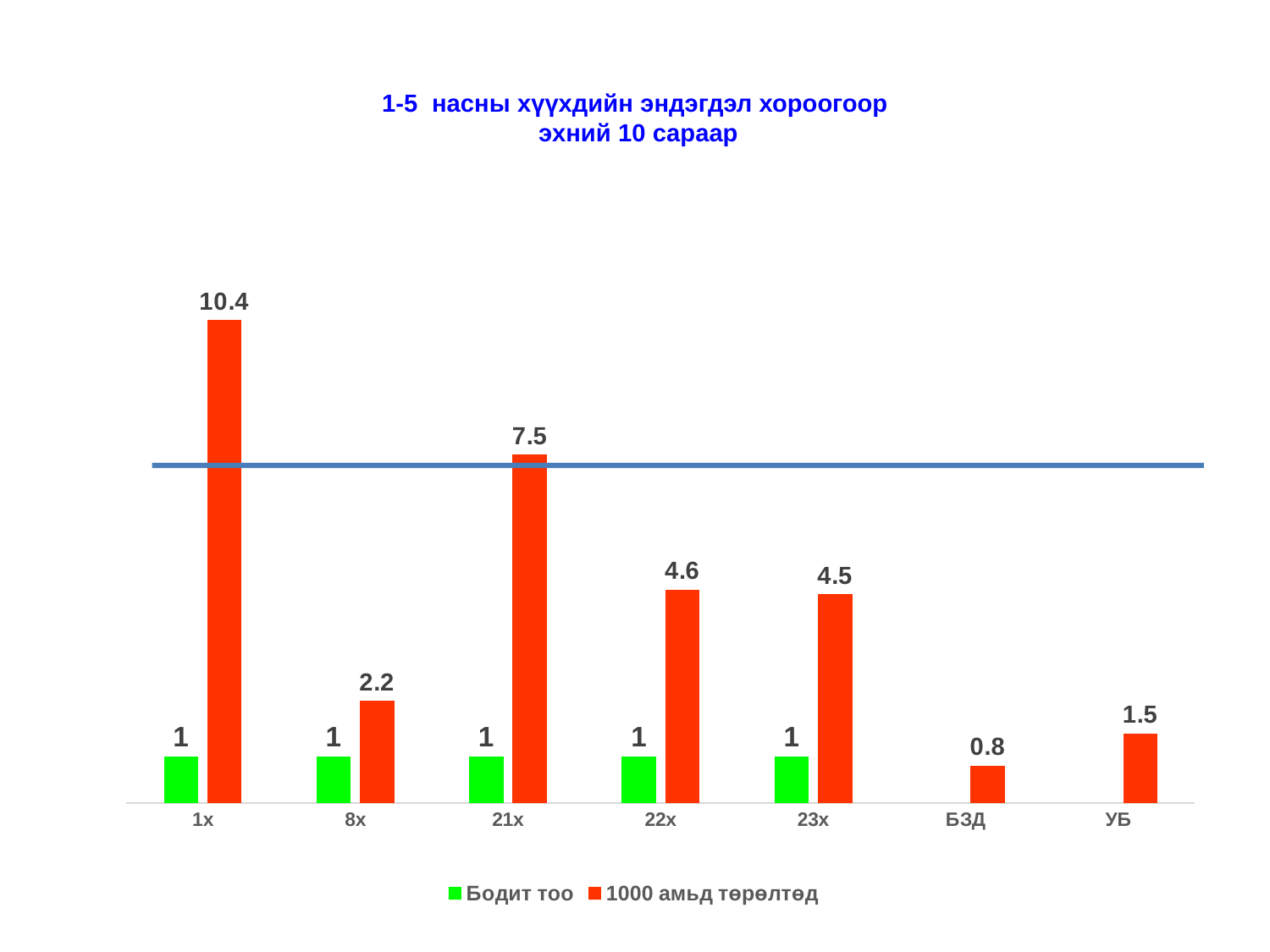
What is the value of the '1000 амьд төрөлтөд' series for 21х? 7.5 What is the difference between the '1000 амьд төрөлтөд' values for 1х and 21х? 2.9 How many series does the legend list? 2 How many categories are shown on the x axis? 7 What is the value of the 'Бодит тоо' series for 22х? 1 Which category has the lowest value in the '1000 амьд төрөлтөд' series? БЗД What kind of chart is shown on the slide? Bar chart What colour are the bars for the 'Бодит тоо' series? Green What is the value of the '1000 амьд төрөлтөд' series for 1х? 10.4 Which category has the highest value in the '1000 амьд төрөлтөд' series? 1х What is the value of the '1000 амьд төрөлтөд' series for БЗД? 0.8 Which is larger in the '1000 амьд төрөлтөд' series: 8х or УБ? 8х